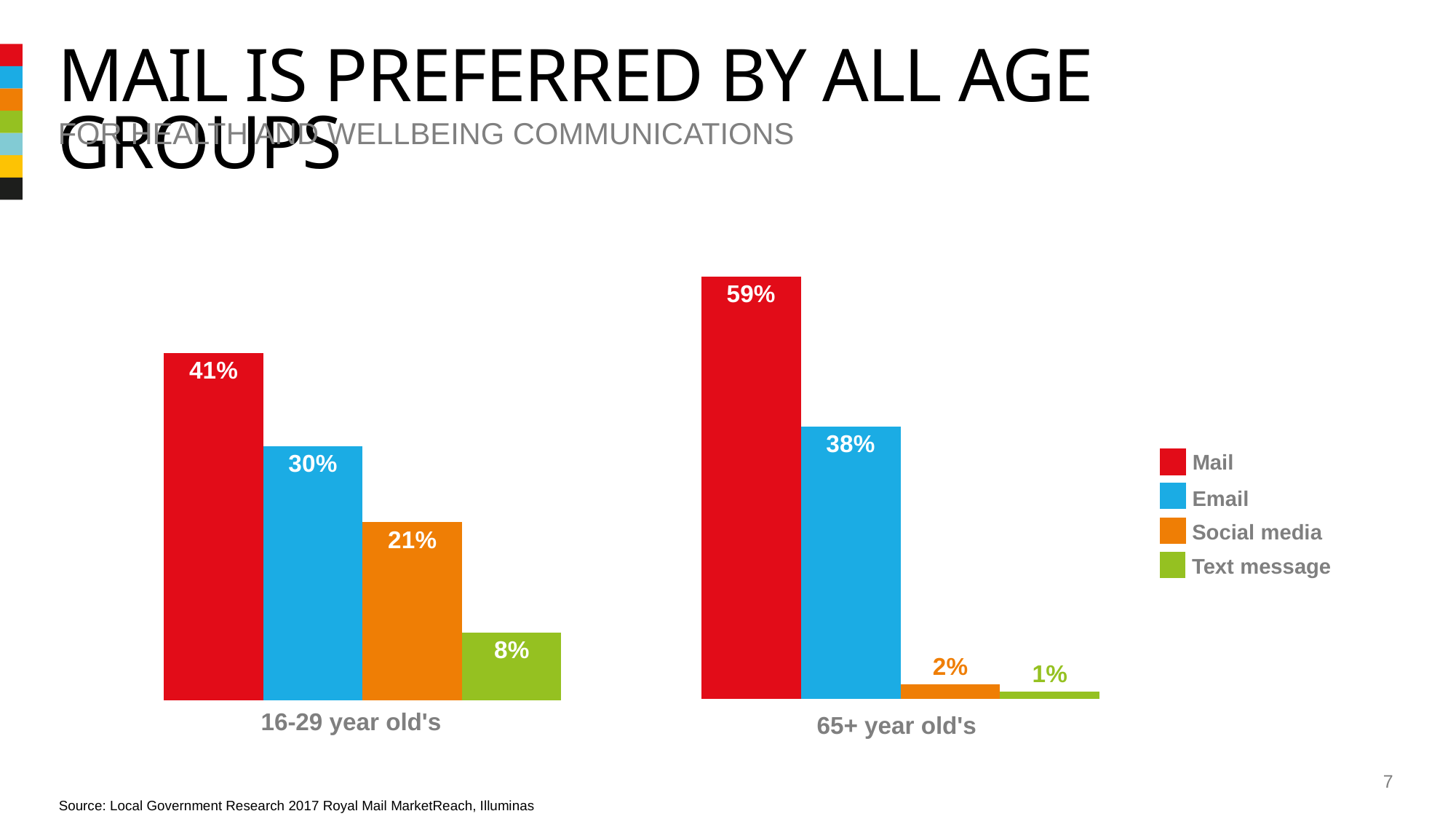
What is the value for Social media among 65+ year old's? 2% Which is larger: Social media for 16-29 year old's or Email for 65+ year old's? Email for 65+ year old's Which communication channel has the highest value for 65+ year old's? Mail Which communication channel has the lowest value for 16-29 year old's? Text message What is the difference between the Mail values for 65+ year old's and 16-29 year old's? 18% What percentage of 16-29 year old's prefer Mail? 41% What is the difference between Email and Social media for 16-29 year old's? 9% How many series does the legend list? 4 What is the value for Text message among 16-29 year old's? 8% What is the value for Email among 65+ year old's? 38% What colour represents Social media in the chart? Orange What kind of chart is shown on the slide? Bar chart